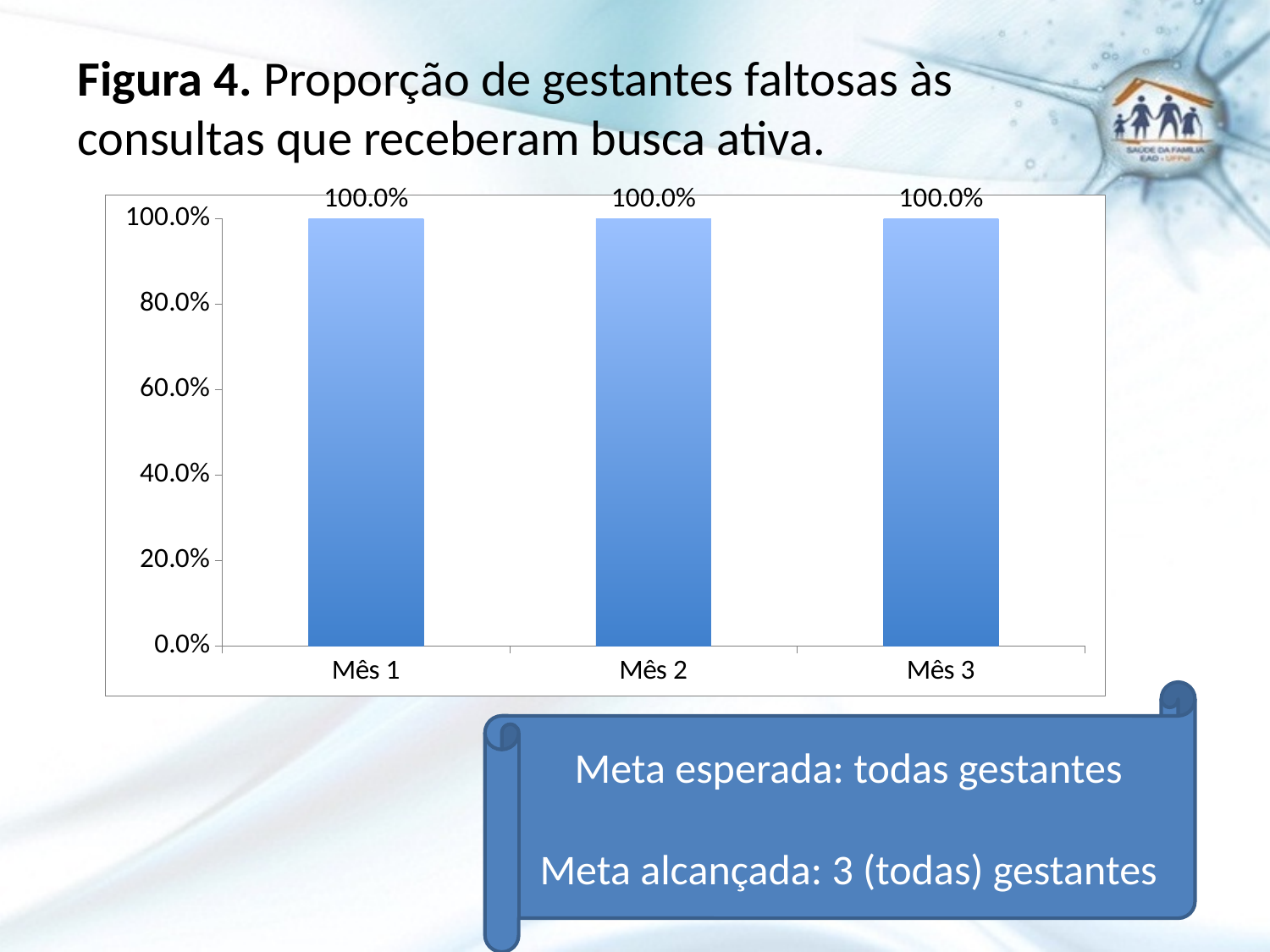
Do the values rise, fall or stay the same from Mês 1 to Mês 3? stay the same What is the title of the figure shown on the slide? Figura 4. Proporção de gestantes faltosas às consultas que receberam busca ativa. What is the difference between the values for Mês 1 and Mês 3? 0.0% What is the value for Mês 1? 100.0% Is the value for Mês 2 greater or less than 80.0%? greater What is the highest value shown on the y axis of the chart? 100.0% How many categories are shown on the x axis of the chart? 3 What is the value for Mês 2? 100.0% What kind of chart is shown on the slide? bar chart What is the value for Mês 3? 100.0%